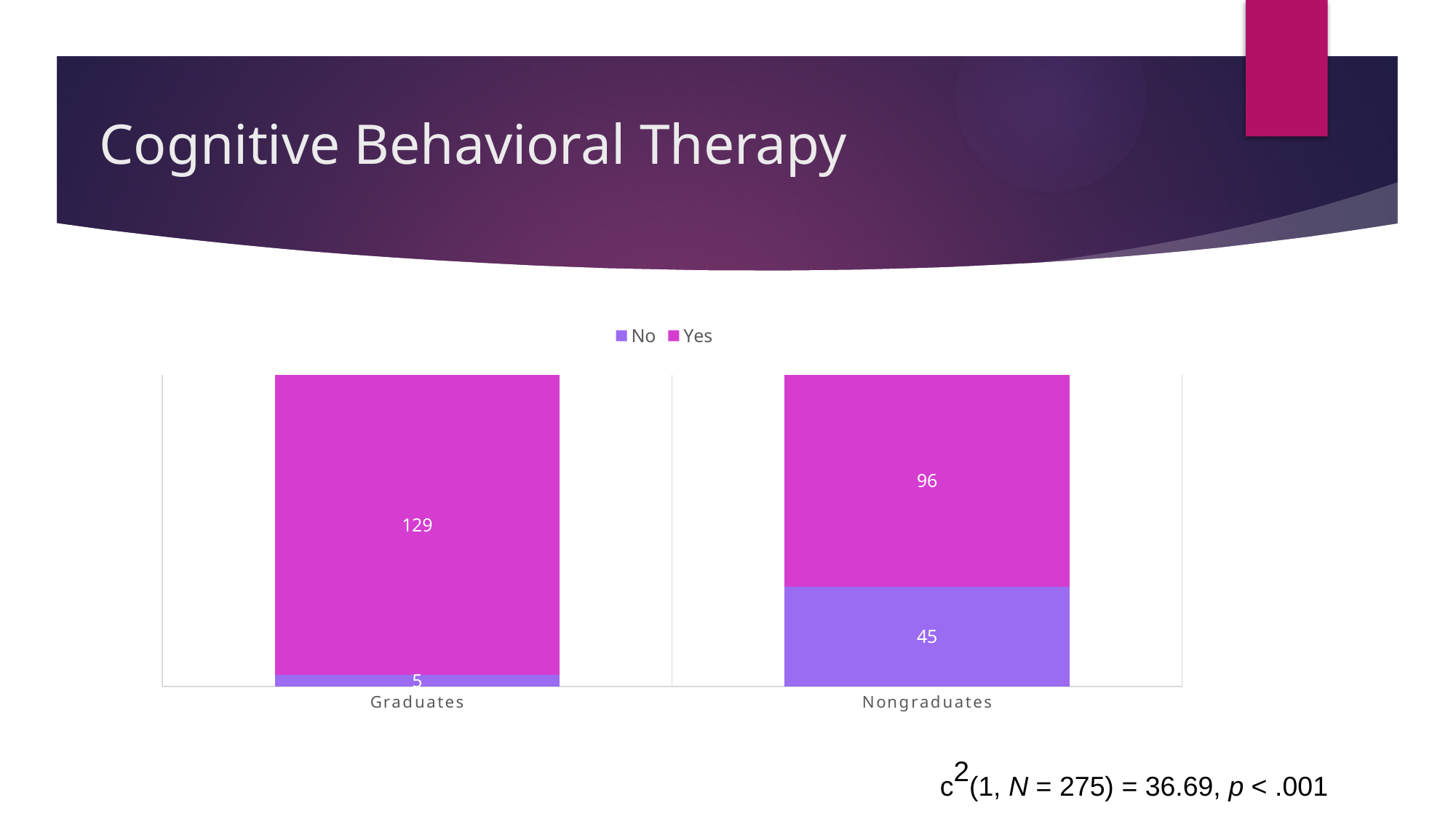
What is the value for Yes in the Nongraduates bar? 96 What is the value for No in the Graduates bar? 5 What is the total of the Nongraduates stacked bar? 141 What is the total of the Graduates stacked bar? 134 Which category has the higher No value, Graduates or Nongraduates? Nongraduates What is the difference between the No values for Nongraduates and Graduates? 40 Which category has the higher Yes value? Graduates What is the value for No in the Nongraduates bar? 45 How many series does the legend list? 2 What kind of chart is shown on the slide? Stacked bar chart What is the value for Yes in the Graduates bar? 129 What is the difference between the Yes values for Graduates and Nongraduates? 33